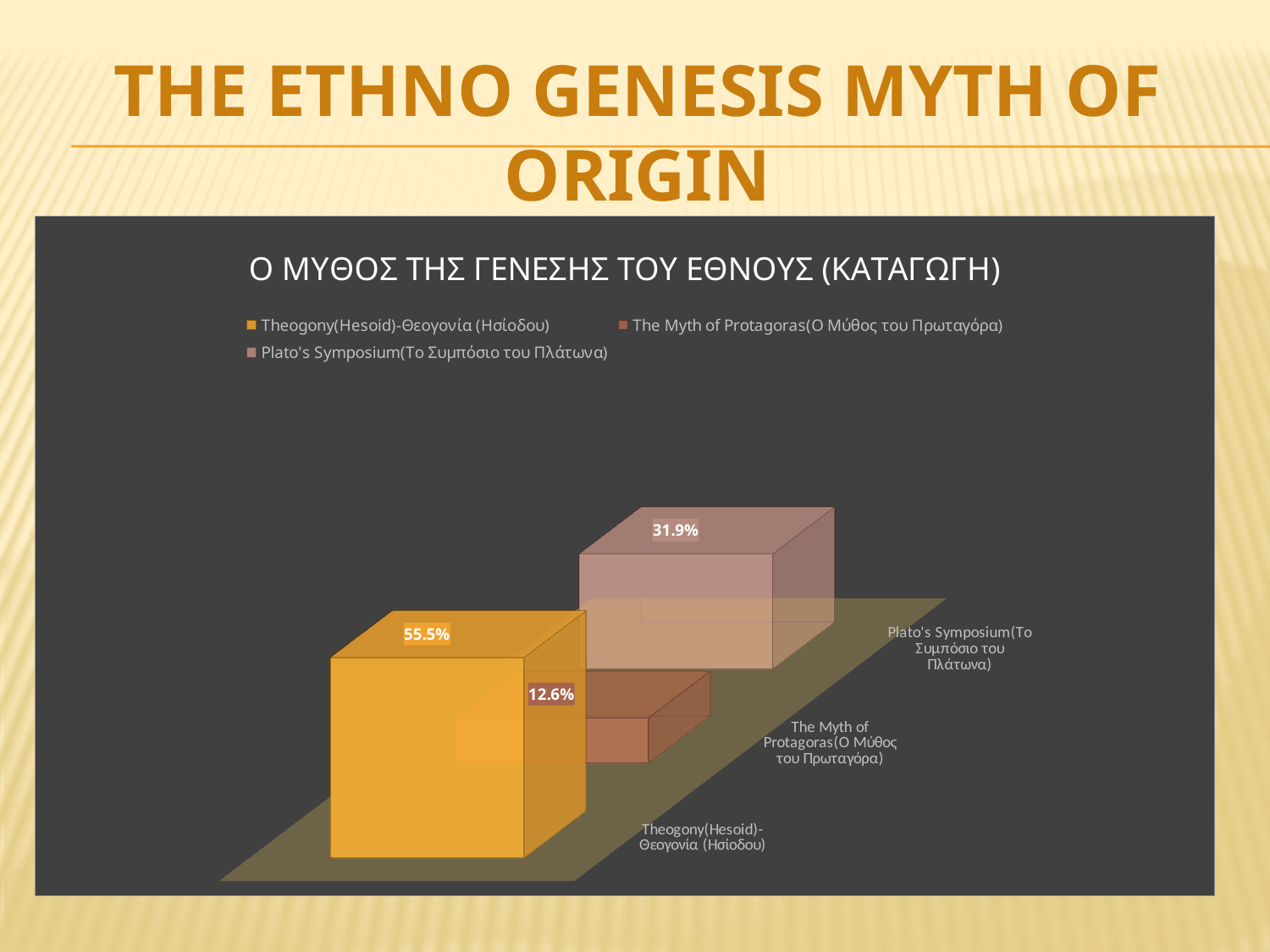
What is the difference between the values for Theogony(Hesoid) and Plato's Symposium? 23.6% What kind of chart is shown on the slide? Bar chart What is the value for Plato's Symposium(Το Συμπόσιο του Πλάτωνα)? 31.9% What is the title of the chart? Ο ΜΥΘΟΣ ΤΗΣ ΓΕΝΕΣΗΣ ΤΟΥ ΕΘΝΟΥΣ (ΚΑΤΑΓΩΓΗ) Which is larger, the value for Plato's Symposium or the value for The Myth of Protagoras? Plato's Symposium Which category has the highest value? Theogony(Hesoid)-Θεογονία (Ησίοδου) How many entries does the legend list? 3 What is the difference between the values for Plato's Symposium and The Myth of Protagoras? 19.3% How many categories are shown in the chart? 3 What is the value for Theogony(Hesoid)-Θεογονία (Ησίοδου)? 55.5% Which category has the lowest value? The Myth of Protagoras(Ο Μύθος του Πρωταγόρα) What is the value for The Myth of Protagoras(Ο Μύθος του Πρωταγόρα)? 12.6%